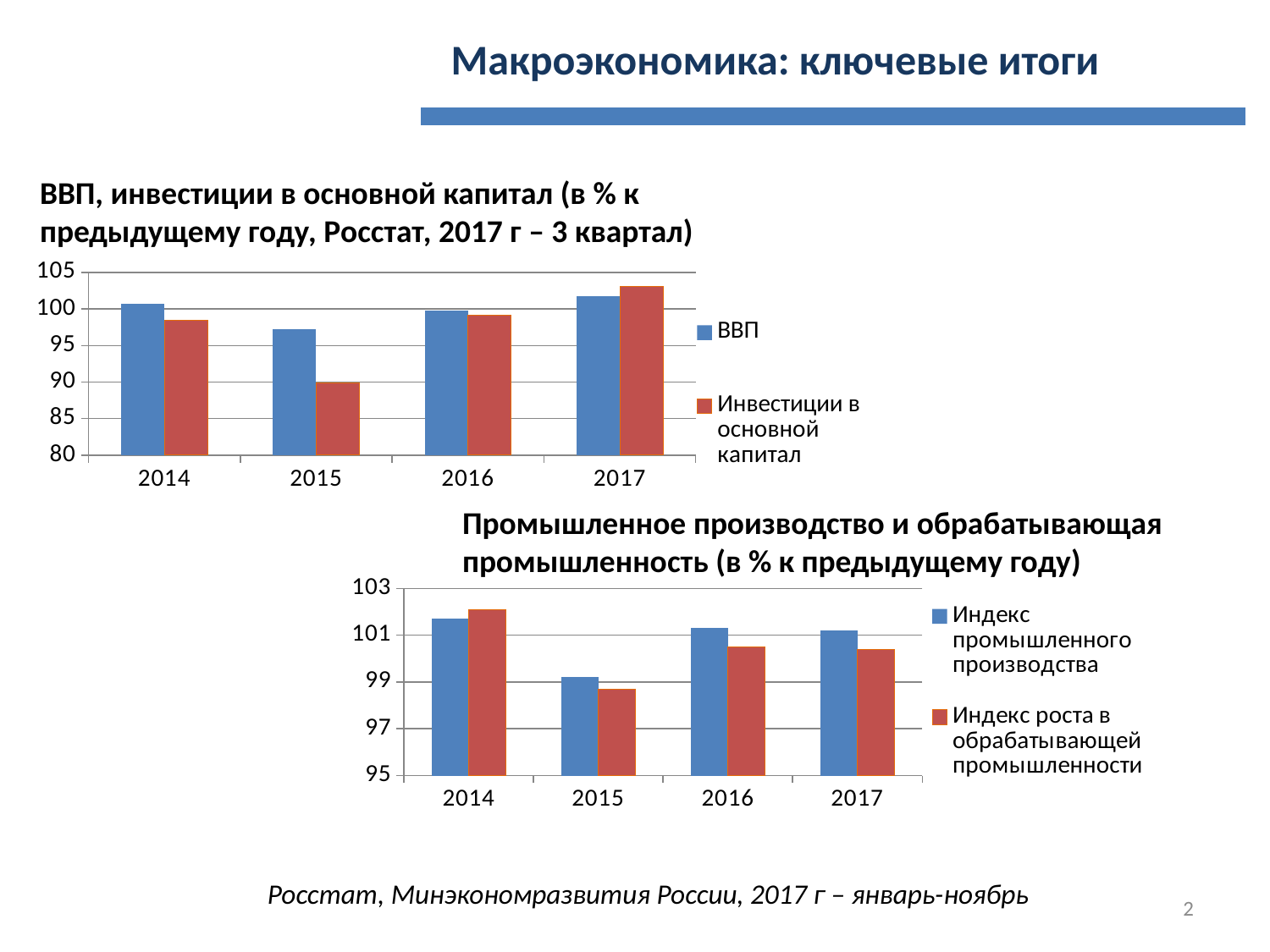
How many years are shown on the x axis of the bottom chart (Промышленное производство и обрабатывающая промышленность)? 4 What kind of chart is the top chart (ВВП, инвестиции в основной капитал)? bar chart In the bottom chart (Промышленное производство и обрабатывающая промышленность), which is larger in 2014: Индекс промышленного производства or Индекс роста в обрабатывающей промышленности? Индекс роста в обрабатывающей промышленности In the bottom chart (Промышленное производство и обрабатывающая промышленность), is the value for Индекс роста в обрабатывающей промышленности in 2014 greater or less than 101? greater In the top chart (ВВП, инвестиции в основной капитал), which is larger in 2017: ВВП or Инвестиции в основной капитал? Инвестиции в основной капитал In the top chart (ВВП, инвестиции в основной капитал), which year has the lowest value for ВВП? 2015 In the bottom chart (Промышленное производство и обрабатывающая промышленность), which year has the lowest value for Индекс промышленного производства? 2015 How many series does the legend of the top chart (ВВП, инвестиции в основной капитал) list? 2 In the top chart (ВВП, инвестиции в основной капитал), which year has the highest value for Инвестиции в основной капитал? 2017 In the top chart (ВВП, инвестиции в основной капитал), which year has the lowest value for Инвестиции в основной капитал? 2015 In the top chart (ВВП, инвестиции в основной капитал), is the value for Инвестиции в основной капитал in 2015 greater or less than 95? less In the top chart (ВВП, инвестиции в основной капитал), is the value for ВВП in 2015 greater or less than 100? less